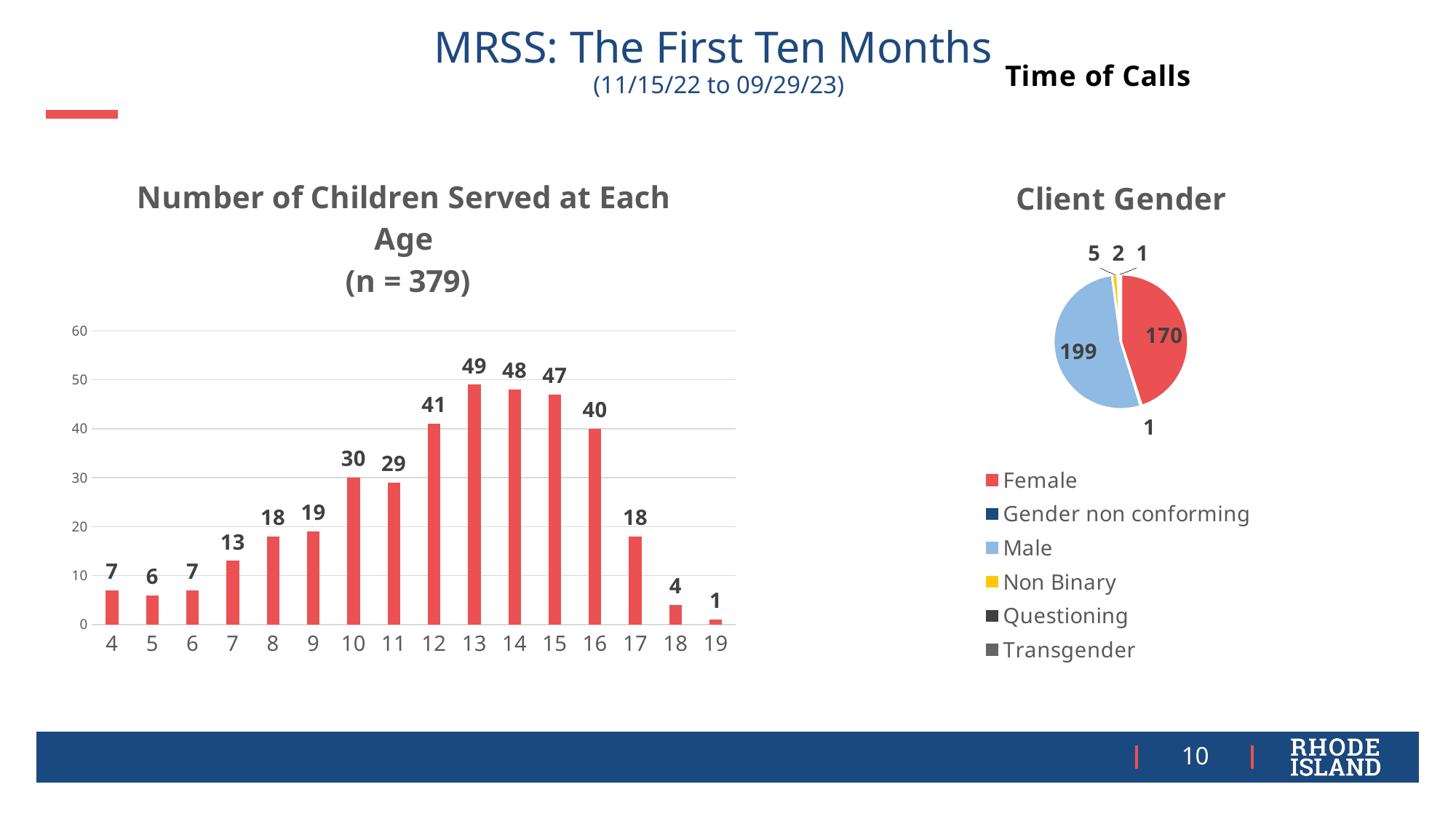
In the 'Client Gender' chart, how many categories does the legend list? 6 In the 'Number of Children Served at Each Age' chart, how many age categories are shown? 16 In the 'Number of Children Served at Each Age' chart, which age has the lowest number of children served? 19 In the 'Client Gender' chart, how many clients are Female? 170 In the 'Number of Children Served at Each Age' chart, do the values rise or fall from age 13 to age 19? Fall In the 'Client Gender' chart, which is larger, Male or Female? Male What kind of chart is 'Number of Children Served at Each Age'? Bar chart In the 'Client Gender' chart, how many clients are Male? 199 In the 'Number of Children Served at Each Age' chart, how many children aged 13 were served? 49 In the 'Number of Children Served at Each Age' chart, what is the difference between the number of children aged 10 and aged 11? 1 In the 'Number of Children Served at Each Age' chart, which age has more children served, 14 or 15? 14 In the 'Number of Children Served at Each Age' chart, which age has the highest number of children served? 13